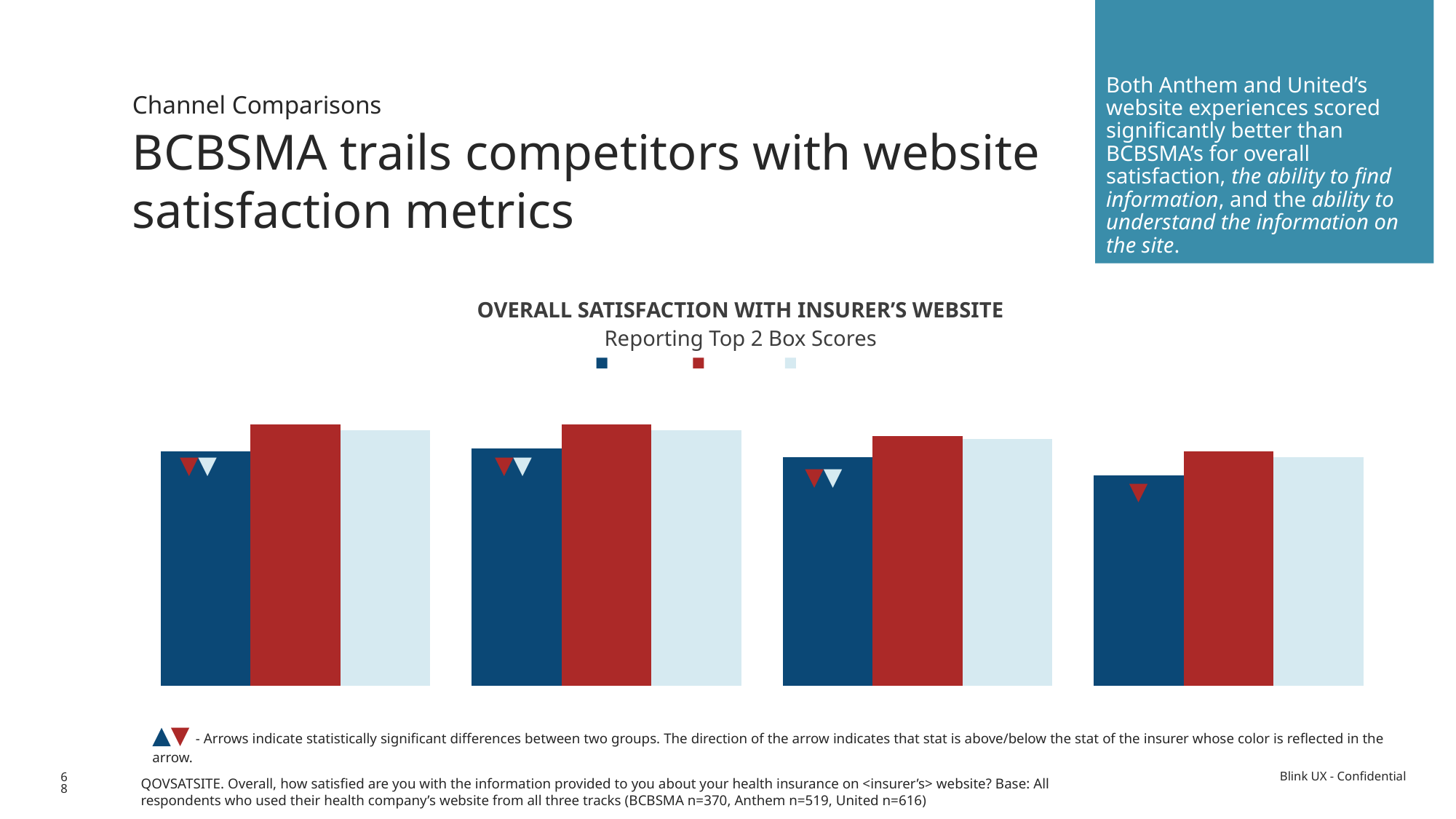
In the rightmost group of bars, which colour bar is the shortest? the dark blue bar How many series does the chart's legend show? 3 What is the title of the chart? OVERALL SATISFACTION WITH INSURER'S WEBSITE In the third group of bars from the left, which is taller: the dark blue bar or the light blue bar? the light blue bar What subtitle appears under the chart's title? Reporting Top 2 Box Scores In the second group of bars from the left, which colour bar is the shortest? the dark blue bar In the leftmost group of bars, which is taller: the dark blue bar or the red bar? the red bar What kind of chart is shown on the slide? bar chart How many groups of bars are plotted in the chart? 4 In the rightmost group of bars, which is taller: the dark blue bar or the red bar? the red bar How many bars are plotted in the chart in total? 12 Which group of bars has the shortest dark blue bar? the rightmost (fourth) group